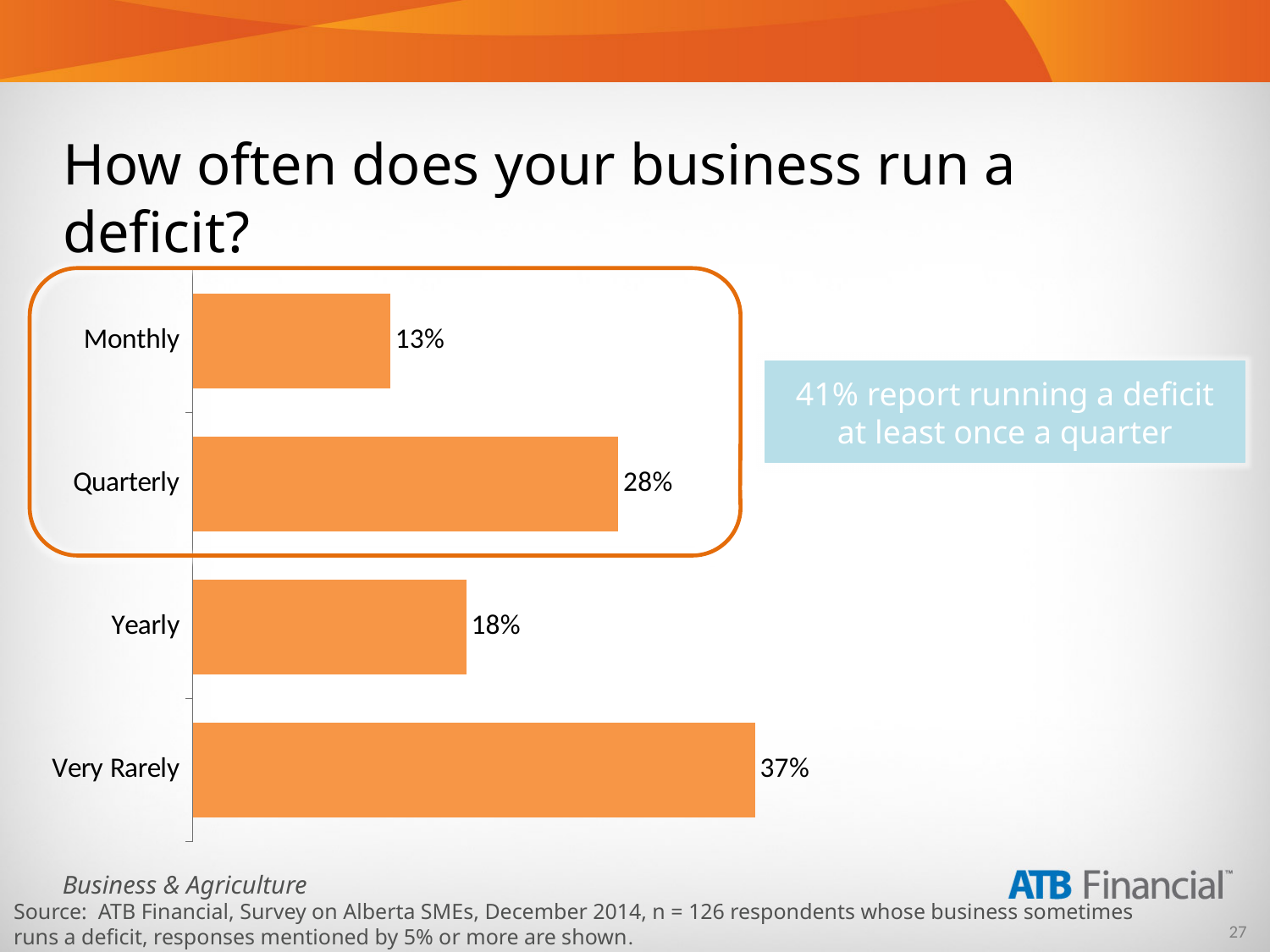
What percentage of businesses report running a deficit yearly? 18% Which category has the lowest percentage? Monthly What kind of chart is shown on the slide? Bar chart What is the combined percentage of Monthly and Quarterly responses? 41% Which is larger, the value for Quarterly or the value for Yearly? Quarterly Which category has the highest percentage? Very Rarely What percentage of businesses report running a deficit very rarely? 37% What percentage of businesses report running a deficit quarterly? 28% What is the difference in percentage points between Yearly and Monthly? 5 How many categories are shown in the chart? 4 What is the difference in percentage points between Very Rarely and Quarterly? 9 What percentage of businesses report running a deficit monthly? 13%